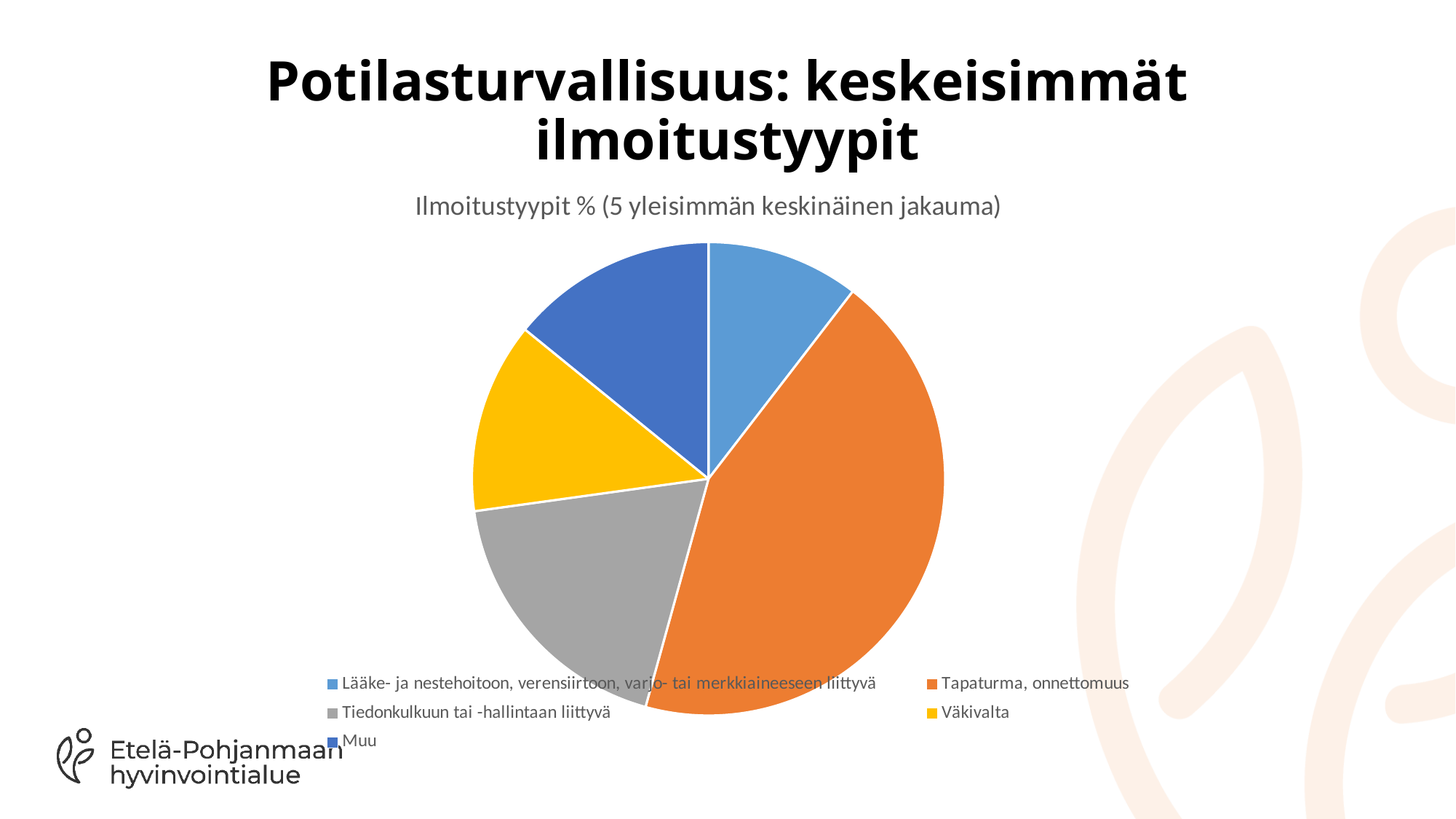
Which slice is larger: Tapaturma, onnettomuus or Muu? Tapaturma, onnettomuus Which slice is larger: Tiedonkulkuun tai -hallintaan liittyvä or Lääke- ja nestehoitoon, verensiirtoon, varjo- tai merkkiaineeseen liittyvä? Tiedonkulkuun tai -hallintaan liittyvä Which category has the largest slice of the pie chart? Tapaturma, onnettomuus What kind of chart is shown on the slide? pie chart Which slice is larger: Tapaturma, onnettomuus or Tiedonkulkuun tai -hallintaan liittyvä? Tapaturma, onnettomuus What is the title of the pie chart? Ilmoitustyypit % (5 yleisimmän keskinäinen jakauma) What colour is the Tapaturma, onnettomuus slice in the pie chart? orange How many slices does the pie chart have? 5